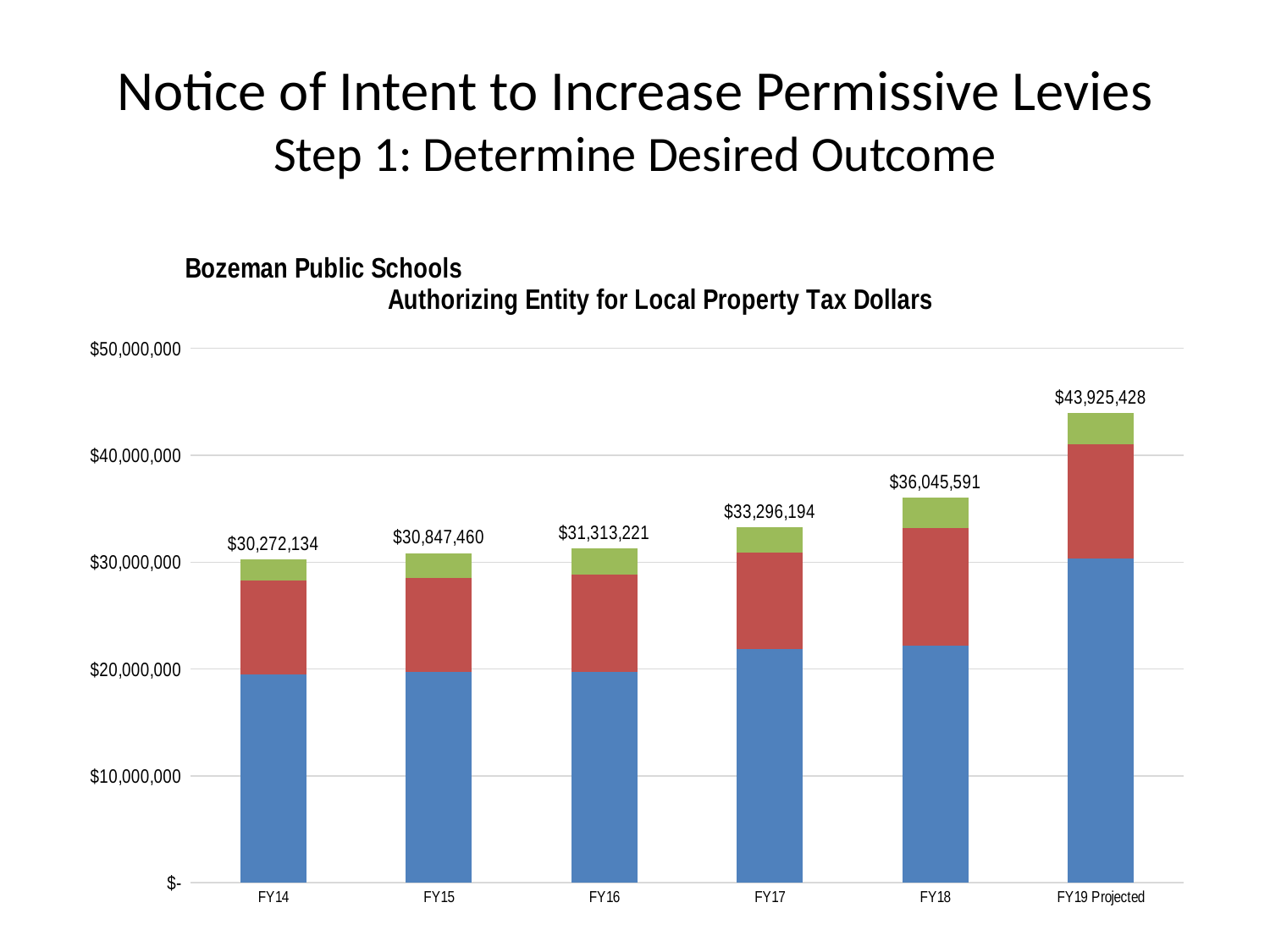
What is the difference between the FY19 Projected total and the FY18 total? $7,879,837 Do the totals rise or fall from FY14 to FY19 Projected? rise Is the blue segment for FY14 greater or less than $20,000,000? less What is the total value shown for FY14? $30,272,134 Which is larger, the total for FY16 or the total for FY18? FY18 What is the difference between the FY15 total and the FY14 total? $575,326 Which fiscal year has the lowest total? FY14 What is the total value shown for FY17? $33,296,194 How many fiscal years are shown on the x axis? 6 What is the total value shown for FY19 Projected? $43,925,428 What kind of chart is shown on the slide? stacked bar chart Which fiscal year has the highest total? FY19 Projected